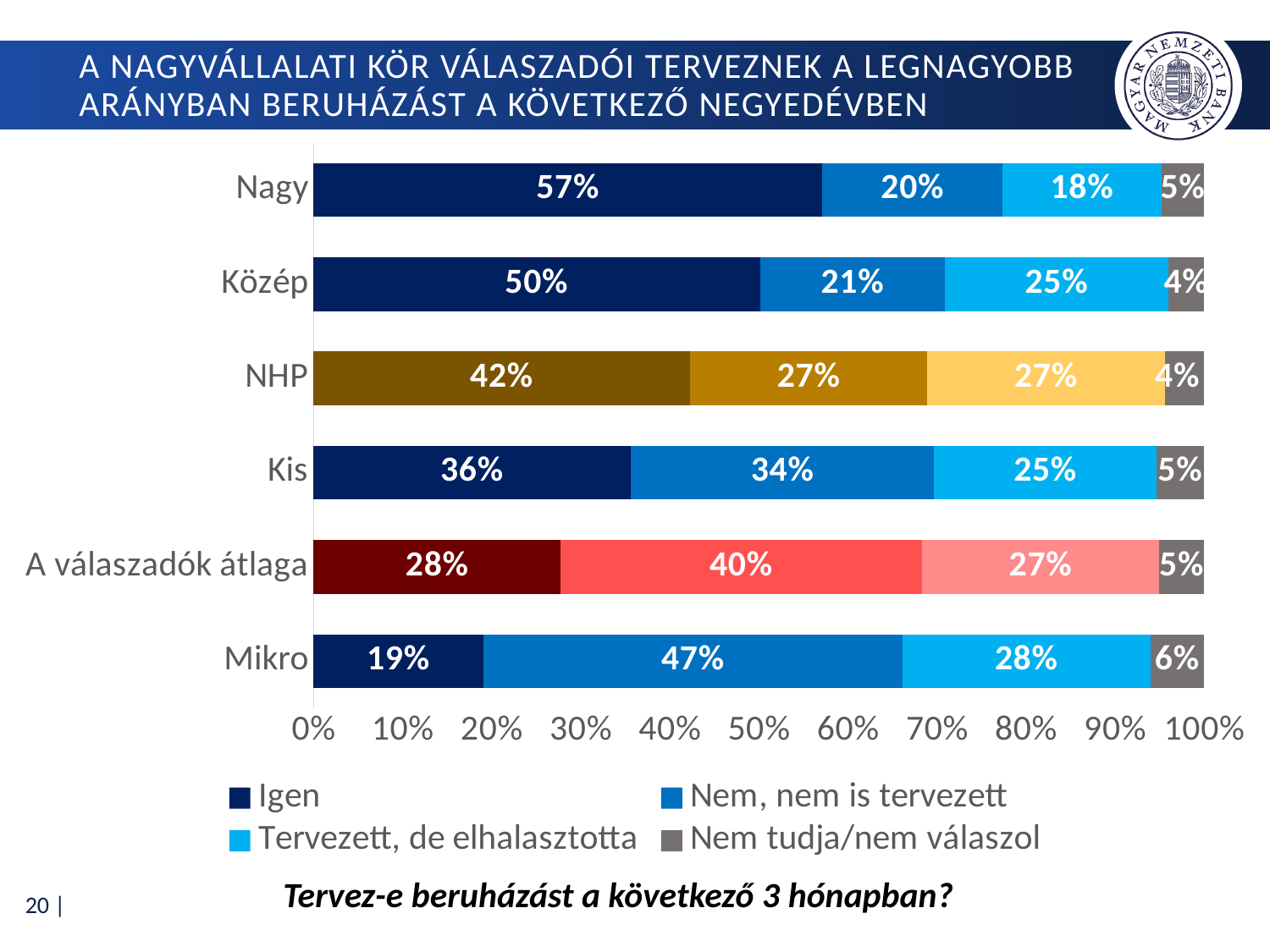
What is the "Nem, nem is tervezett" value for Mikro? 47% What kind of chart is shown on the slide? Stacked bar chart What is the difference between the "Igen" values for Nagy and Mikro? 38 percentage points Which category has the highest "Igen" share? Nagy What is the total of the stacked bar for NHP? 100% Which is larger: the "Nem, nem is tervezett" value for Kis or for Közép? Kis What is the "Nem tudja/nem válaszol" value for Kis? 5% What percentage of Nagy respondents answered "Igen"? 57% How many series does the legend list? 4 Which category has the lowest "Igen" share? Mikro What is the "Tervezett, de elhalasztotta" value for Közép? 25% How many categories are shown on the y axis? 6